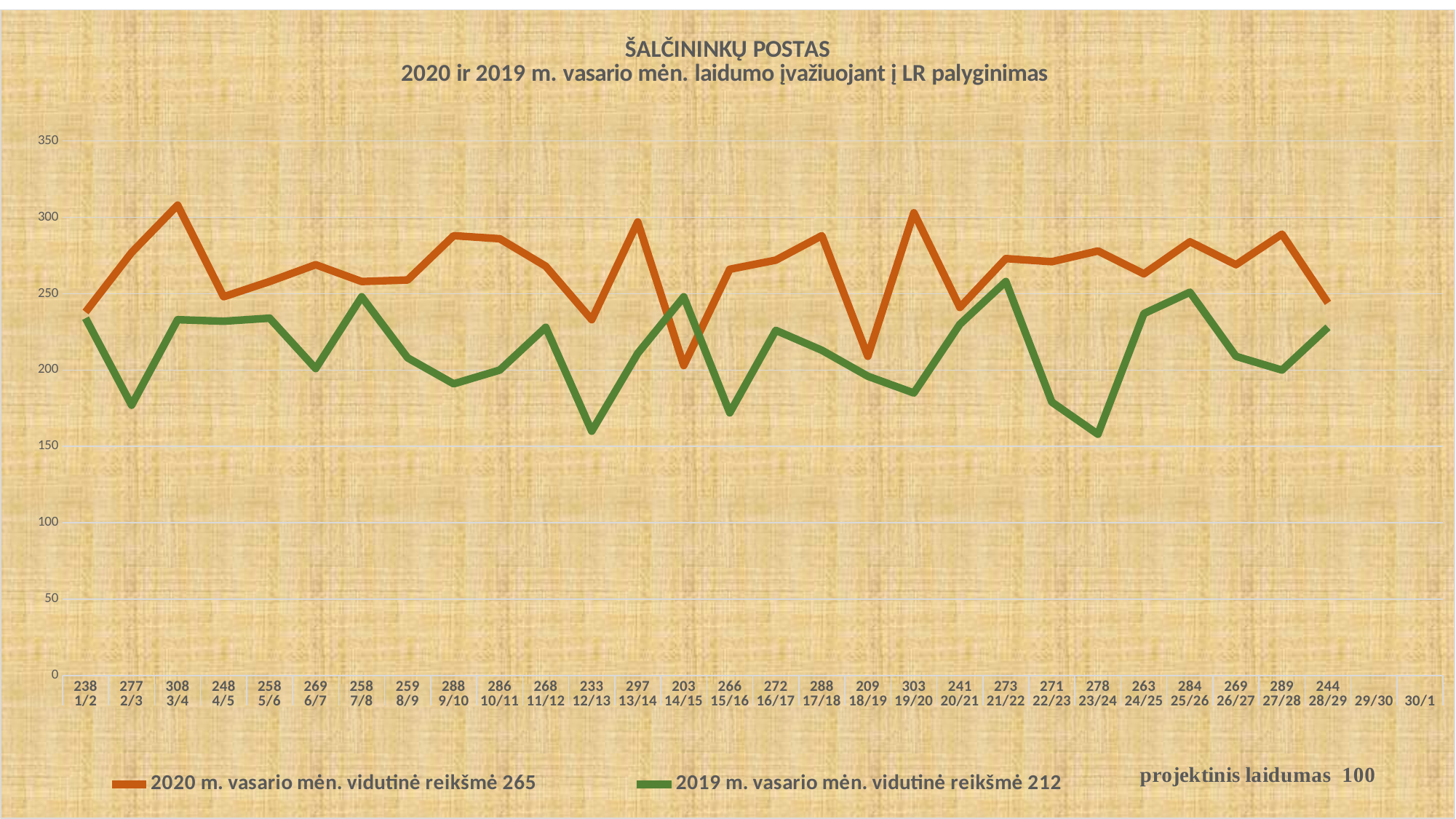
On which date does the 2020 series reach its highest value? 3/4 Is the 2019 value for 12/13 greater or less than 200? less What is the 2020 value for 3/4? 308 How many series does the legend list? 2 What is the 2020 value for 14/15? 203 What type of chart is shown on the slide? line chart On 14/15, which series has the higher value, 2020 or 2019? 2019 Is the 2019 value for 7/8 greater or less than 200? greater What average value (vidutinė reikšmė) does the legend give for the 2020 series? 265 On which date does the 2020 series reach its lowest value? 14/15 What is the 2020 value for 28/29? 244 What is the difference between the 2020 values for 3/4 and 14/15? 105